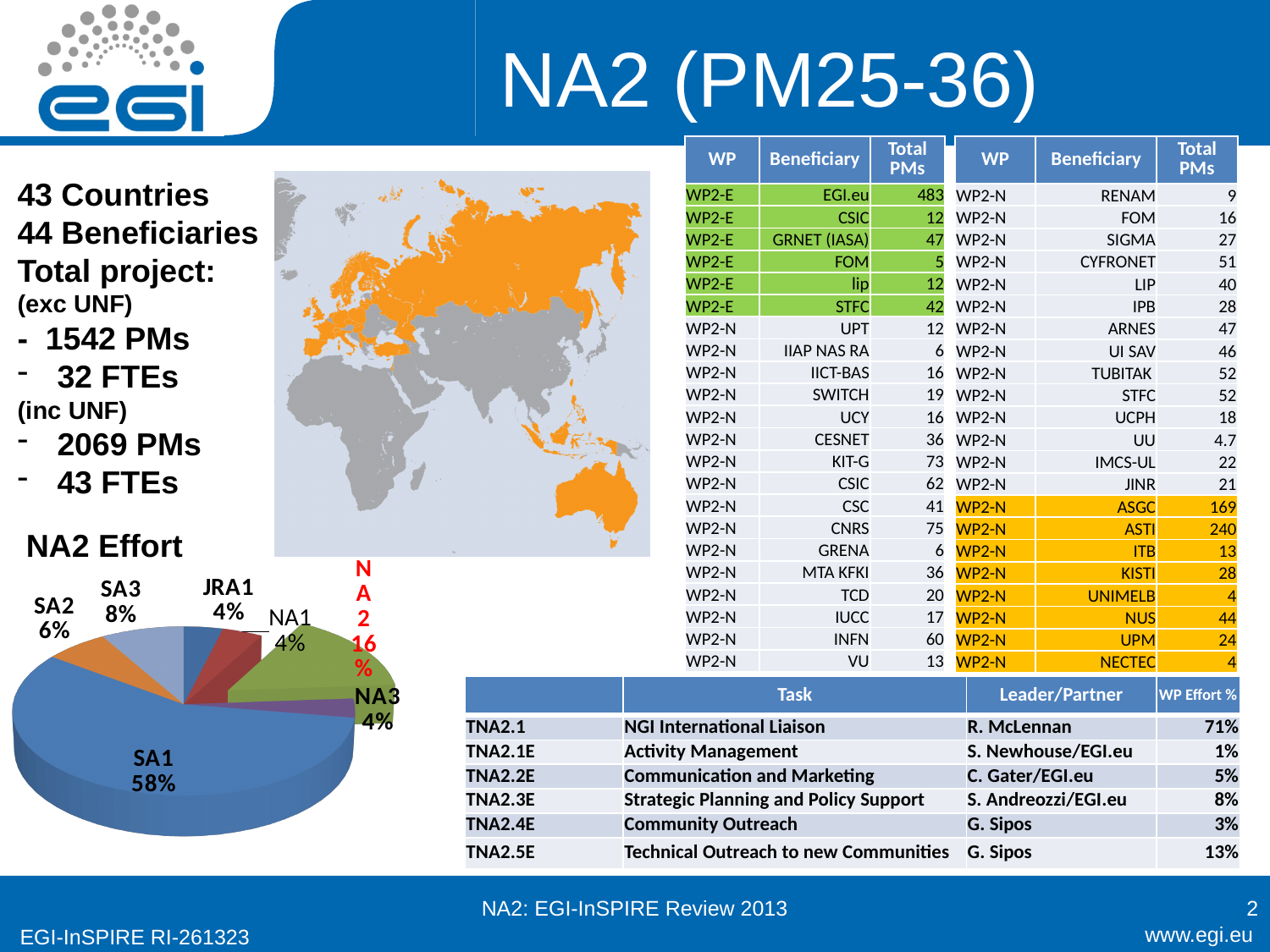
In the NA2 Effort pie chart, what is the difference between the SA1 share and the NA2 share? 42% How many slices does the NA2 Effort pie chart have? 7 What is the title of the pie chart on the slide? NA2 Effort Which slice is the largest in the NA2 Effort pie chart? SA1 In the NA2 Effort pie chart, what share does NA2 have? 16% In the NA2 Effort pie chart, what share does JRA1 have? 4% In the NA2 Effort pie chart, what share does SA1 have? 58% What type of chart is the NA2 Effort chart? pie chart In the NA2 Effort pie chart, what share does SA2 have? 6% In the NA2 Effort pie chart, what share does SA3 have? 8% In the NA2 Effort pie chart, what is the difference between the SA3 share and the SA2 share? 2% In the NA2 Effort pie chart, which is larger, SA3 or SA2? SA3